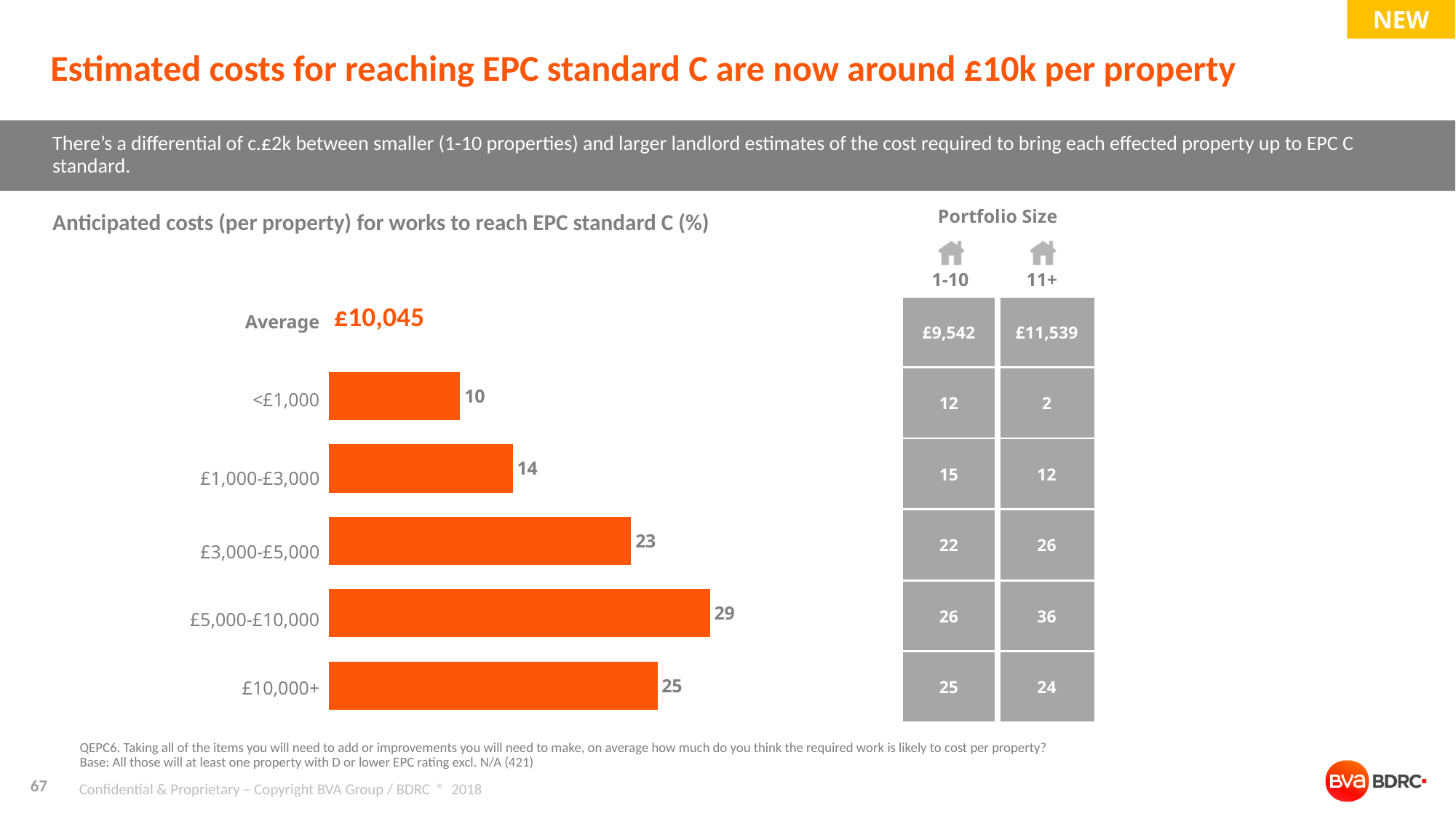
What percentage of landlords anticipate costs of £5,000-£10,000 per property? 29 How many cost bands are shown in the bar chart? 5 Which cost band has the lowest percentage in the bar chart? <£1,000 What type of chart is used to show the anticipated costs? Bar chart What percentage of landlords anticipate costs of £3,000-£5,000 per property? 23 What percentage of landlords anticipate costs of <£1,000 per property? 10 What is the difference in percentage points between the £5,000-£10,000 band and the £10,000+ band? 4 Which cost band has the highest percentage in the bar chart? £5,000-£10,000 Which is larger: the percentage for £1,000-£3,000 or for £3,000-£5,000? £3,000-£5,000 What is the average anticipated cost for landlords with 11+ properties in the Portfolio Size table? £11,539 What is the title of the bar chart? Anticipated costs (per property) for works to reach EPC standard C (%) What is the average anticipated cost per property shown on the chart? £10,045